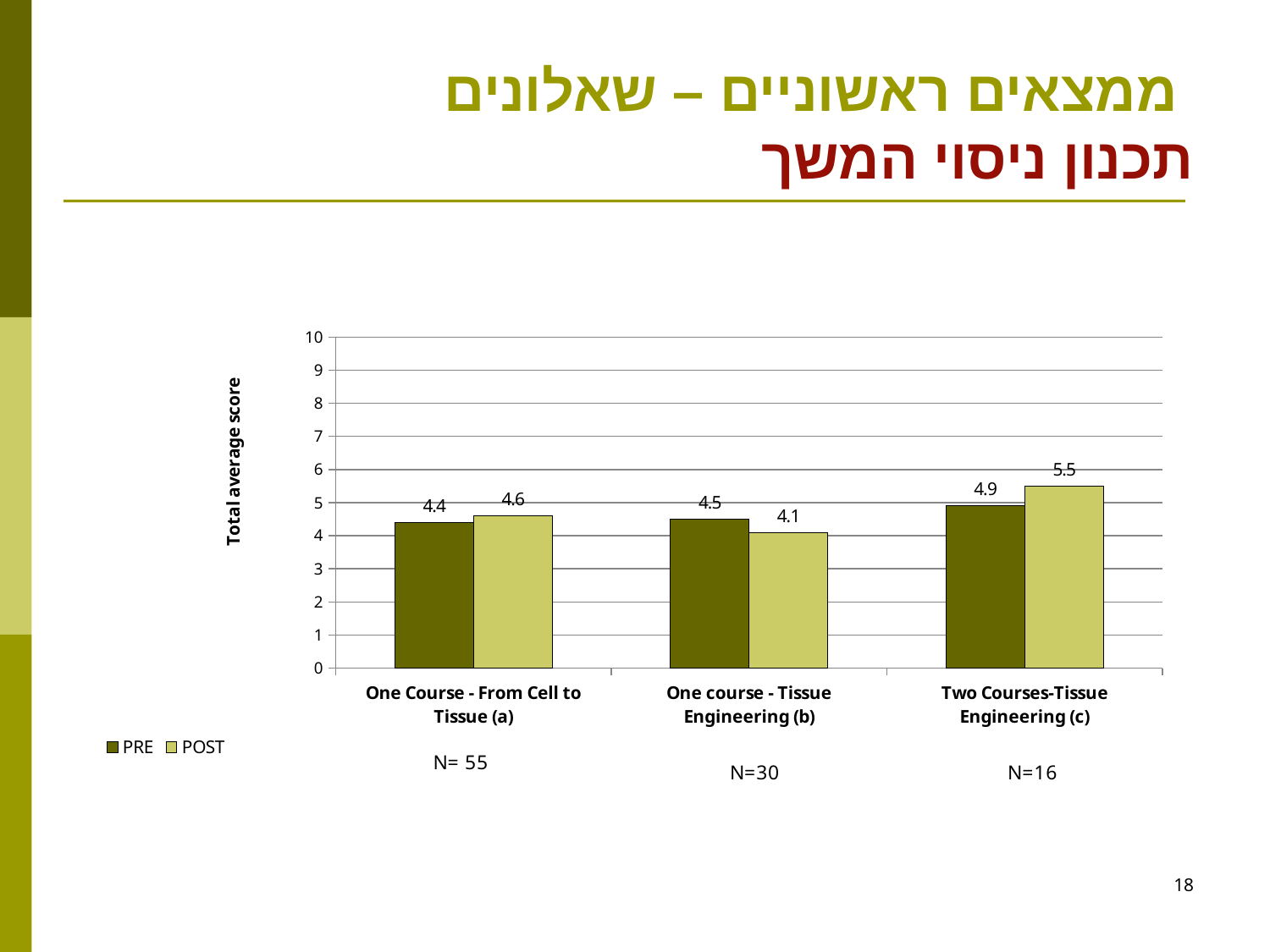
What are the two series named in the legend? PRE and POST Which is larger for One course - Tissue Engineering (b), the PRE value or the POST value? PRE How many categories are shown on the x axis? 3 Which category has the highest POST value? Two Courses-Tissue Engineering (c) What kind of chart is shown on the slide? Bar chart Which category has the lowest POST value? One course - Tissue Engineering (b) What is the difference between the POST and PRE values for Two Courses-Tissue Engineering (c)? 0.6 How many series does the legend list? 2 What is the POST value for One course - Tissue Engineering (b)? 4.1 What is the label of the y axis? Total average score What is the PRE value for One Course - From Cell to Tissue (a)? 4.4 What is the POST value for Two Courses-Tissue Engineering (c)? 5.5